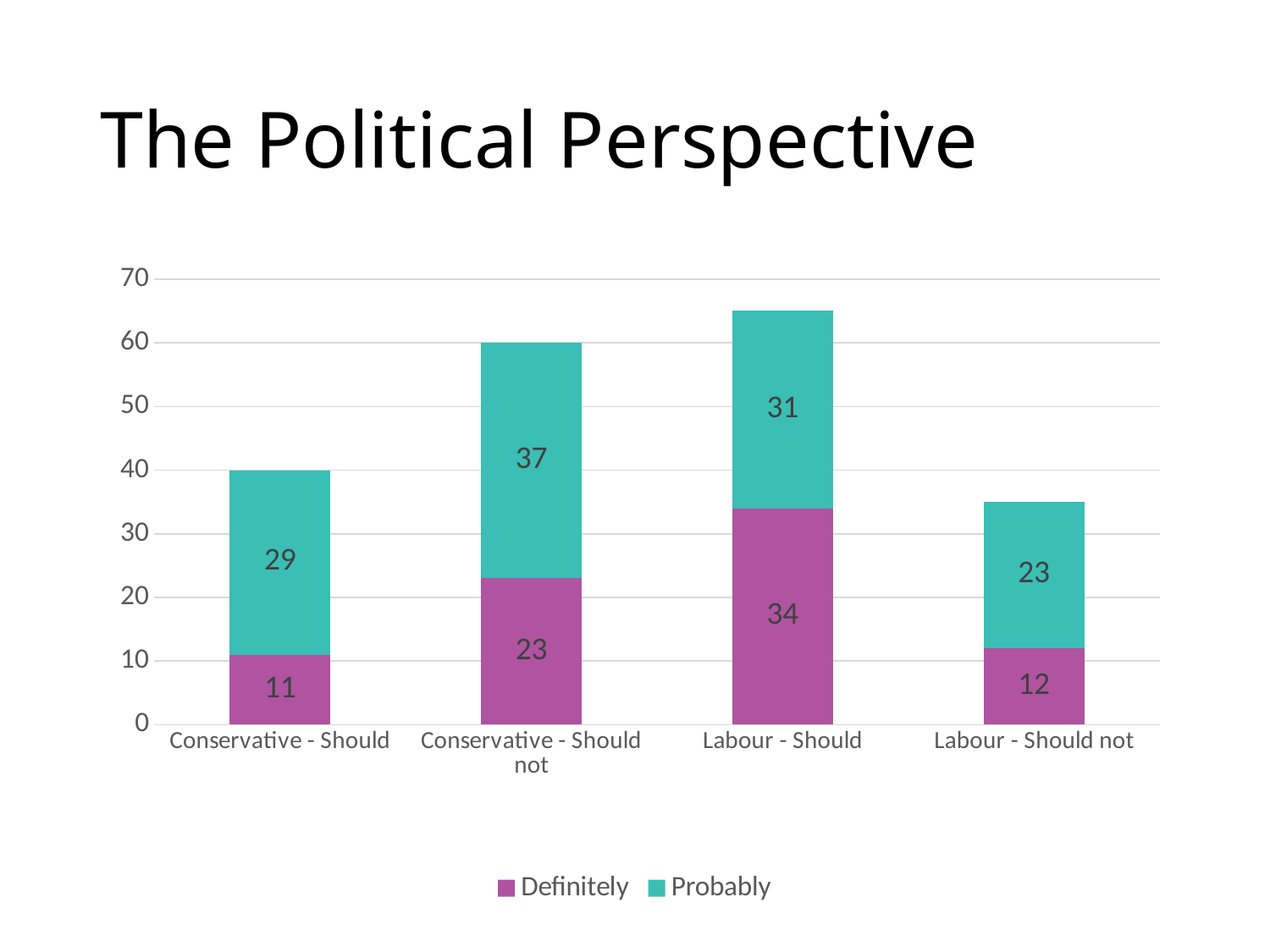
Which category has the lowest Definitely value? Conservative - Should What is the total of the stacked bar for Labour - Should? 65 Which is larger, the Probably value for Conservative - Should or the Probably value for Labour - Should not? Conservative - Should What is the total of the stacked bar for Conservative - Should not? 60 What is the Probably value for Conservative - Should not? 37 What is the Definitely value for Labour - Should? 34 How many categories are shown on the x axis? 4 What is the Definitely value for Conservative - Should? 11 How many series does the legend list? 2 Which category has the highest Probably value? Conservative - Should not What is the difference between the Definitely values for Labour - Should and Labour - Should not? 22 What kind of chart is shown on the slide? Stacked bar chart